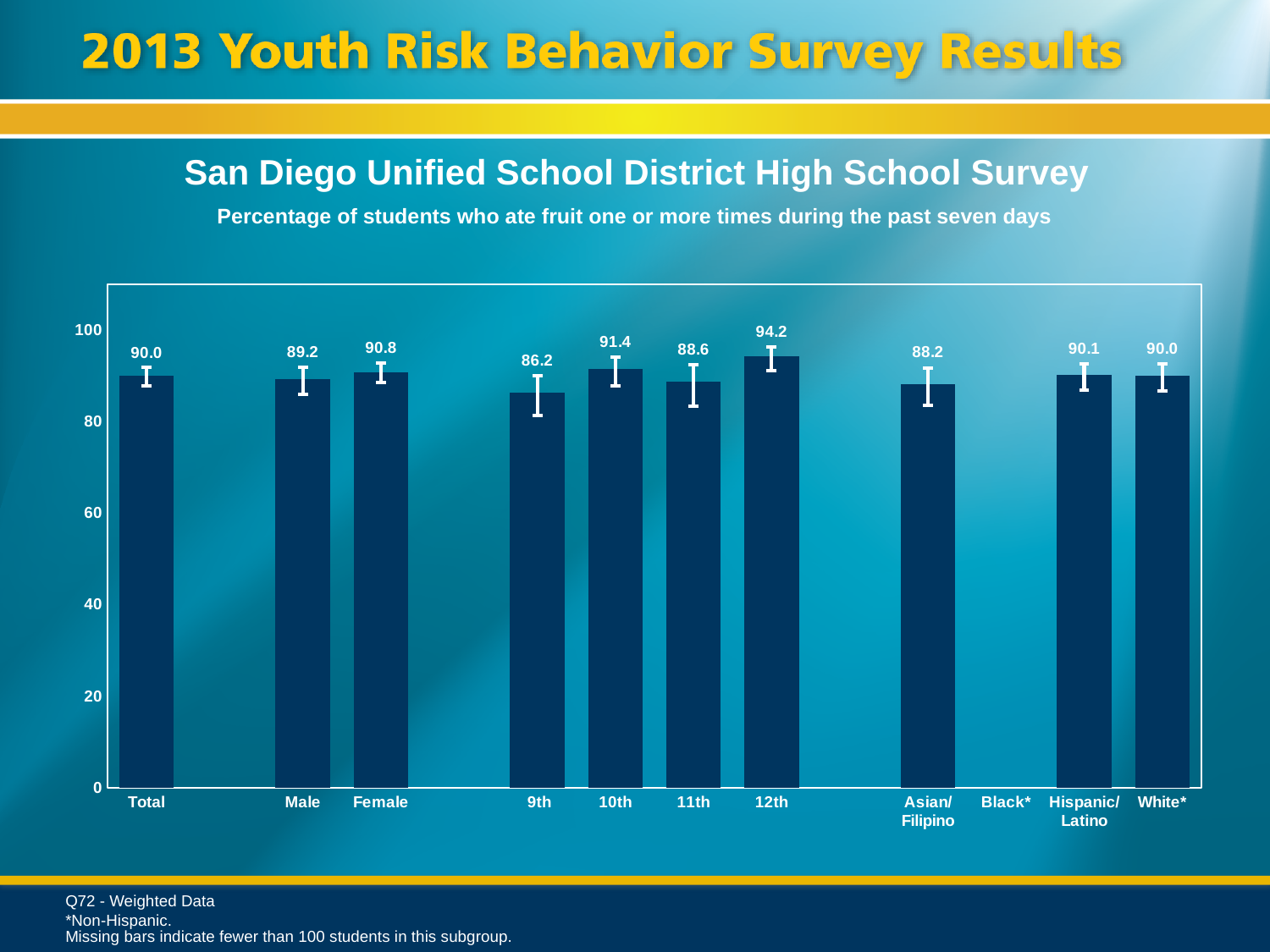
Is the value for 12th greater or less than 80? greater What is the value for 9th grade? 86.2 Which is larger, the value for 10th or the value for 11th? 10th What is the difference between the Female and Male values? 1.6 What is the difference between the 12th and 9th grade values? 8.0 What is the value for Total? 90.0 How many bars are plotted on the chart? 10 What is the value for Asian/Filipino? 88.2 Which category label has no bar plotted? Black* Which category has the lowest value? 9th Which category has the highest value? 12th What kind of chart is shown? bar chart